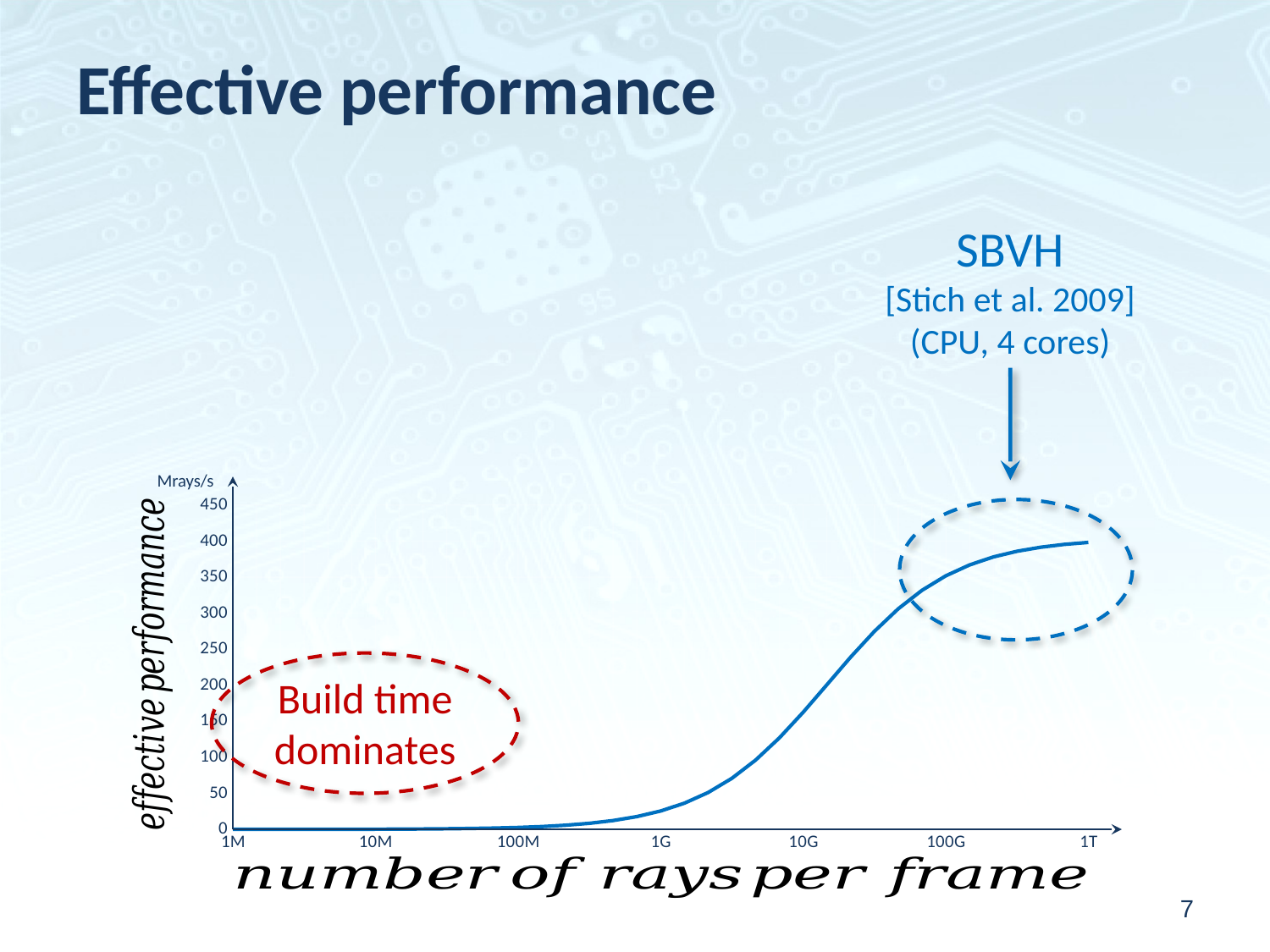
Is the effective performance at 1G rays per frame greater or less than 50 Mrays/s? less Is the effective performance at 1M rays per frame greater or less than 50 Mrays/s? less What is the highest tick value shown on the y axis? 450 Is the effective performance at 10G rays per frame greater or less than 250 Mrays/s? less What kind of chart is shown on the slide? line chart Does the effective performance rise or fall as the number of rays per frame increases along the x axis? rise How many tick labels are shown on the x axis of the chart? 7 What unit is shown at the top of the y axis? Mrays/s